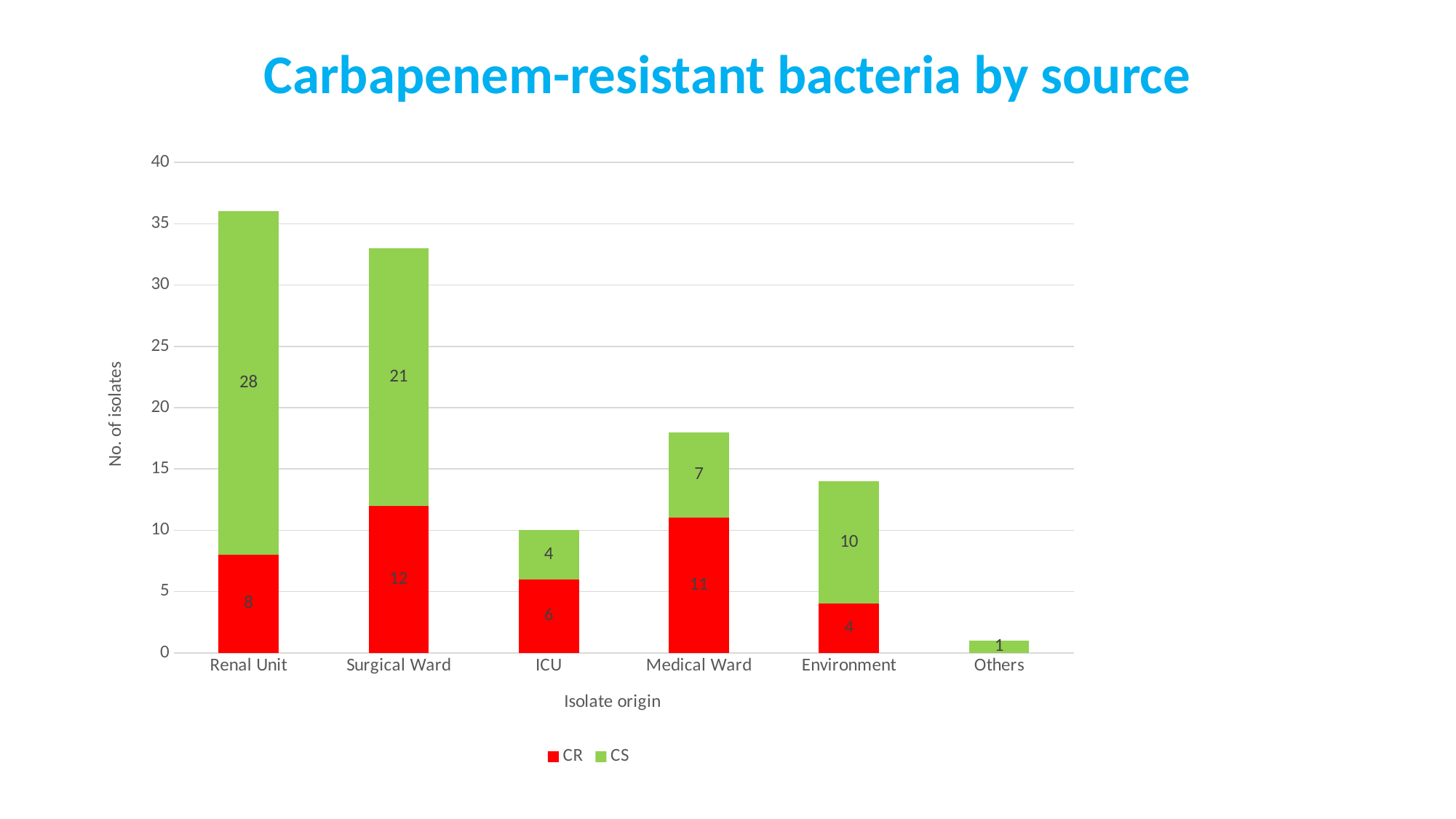
What is the difference between the CS values for Renal Unit and Surgical Ward? 7 Which is larger, the CR value for Medical Ward or the CR value for ICU? Medical Ward How many series does the legend list? 2 What is the CS value for Environment? 10 Which isolate origin has the lowest CR value among those with a CR segment? Environment What kind of chart is shown on the slide? Stacked bar chart What is the CS value for Renal Unit? 28 What is the CR value for Surgical Ward? 12 How many isolate origin categories are shown on the x axis? 6 What is the total of the stacked bar for Renal Unit? 36 What is the total of the stacked bar for Medical Ward? 18 Which isolate origin has the highest CS value? Renal Unit